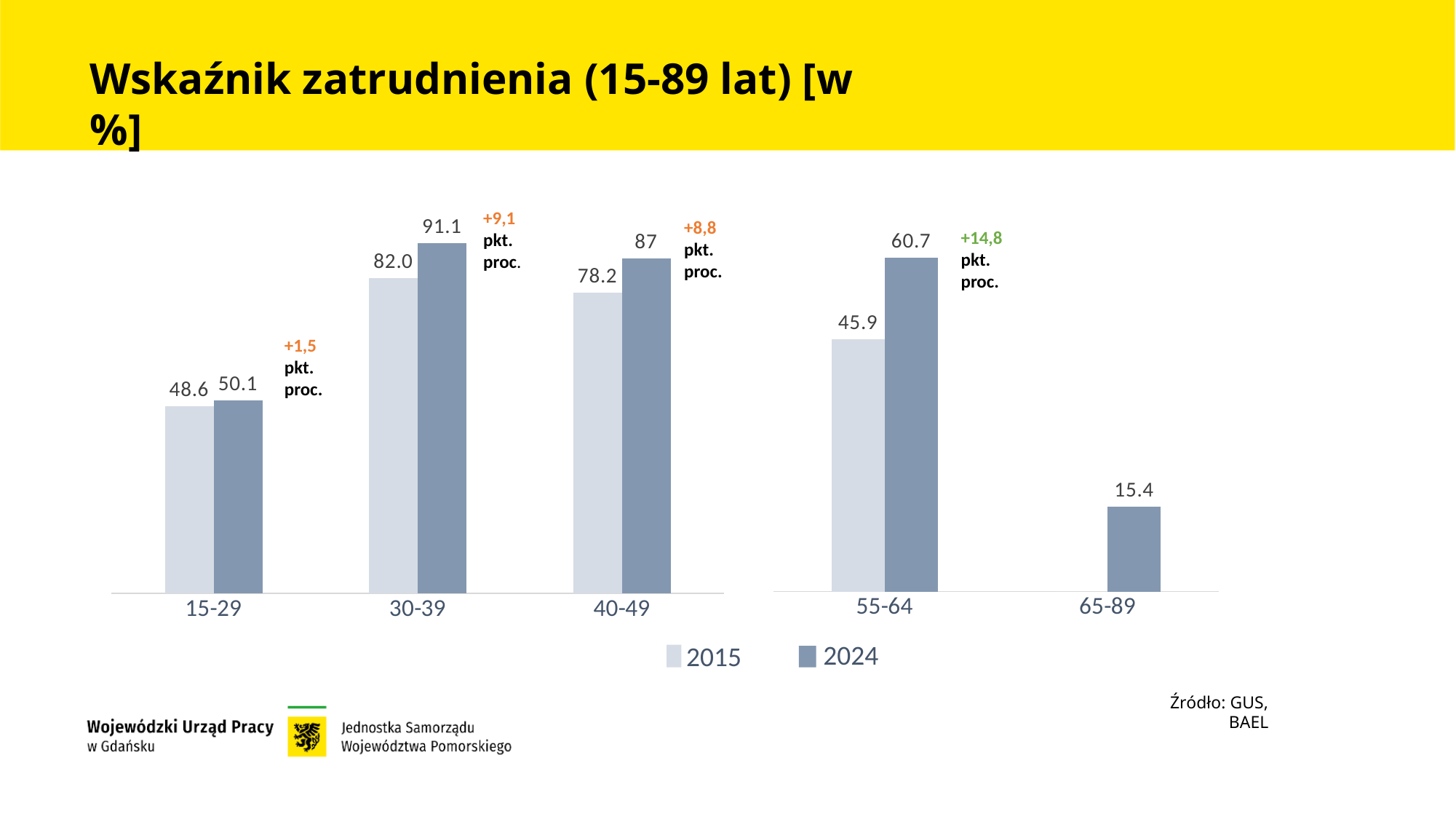
What kind of chart is shown on the slide? bar chart What is the difference between the 2024 and 2015 values for the 40-49 age group? 8.8 How many age groups are shown on the x axis? 5 Which is larger for the 55-64 age group: the 2015 value or the 2024 value? 2024 What change in percentage points is annotated for the 55-64 age group? +14,8 pkt. proc. Which age group has the lowest value in the 2024 series? 65-89 Which age group has the highest value in the 2024 series? 30-39 How many series does the legend list? 2 What is the value for the 15-29 age group in the 2015 series? 48.6 What is the value for the 30-39 age group in the 2024 series? 91.1 What is the value for the 55-64 age group in the 2015 series? 45.9 What is the value for the 65-89 age group in the 2024 series? 15.4